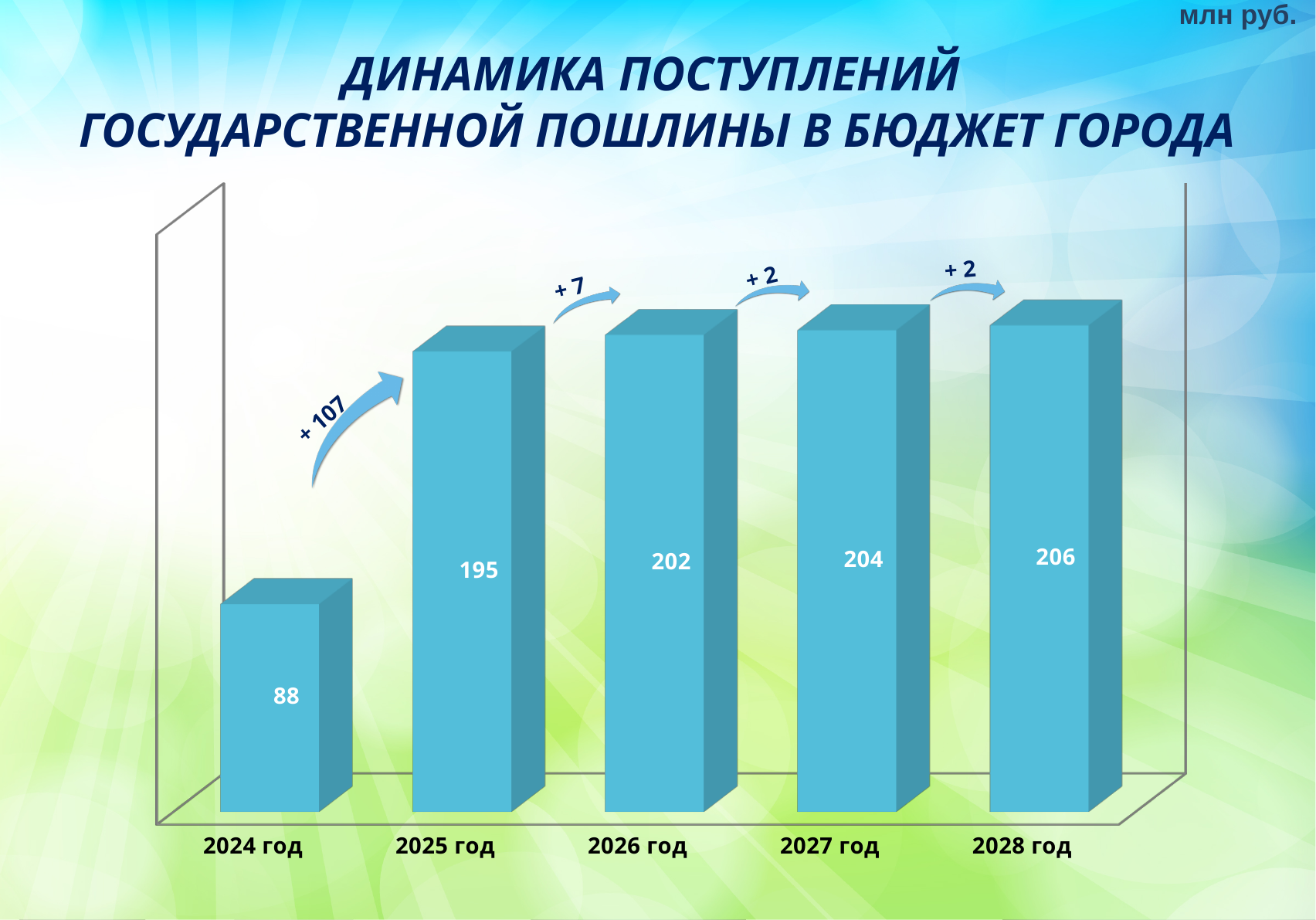
Which year has the lowest value? 2024 год What is the difference between the values for 2028 год and 2026 год? 4 What unit is indicated in the top right corner of the slide? млн руб. What is the value for 2026 год? 202 What is the value for 2024 год? 88 Which is larger, the value for 2025 год or the value for 2027 год? 2027 год What kind of chart is shown on the slide? bar chart Do the values rise or fall from 2024 год to 2028 год? rise How many years are shown on the chart? 5 What is the difference between the values for 2025 год and 2024 год? 107 Which year has the highest value? 2028 год What is the value for 2028 год? 206